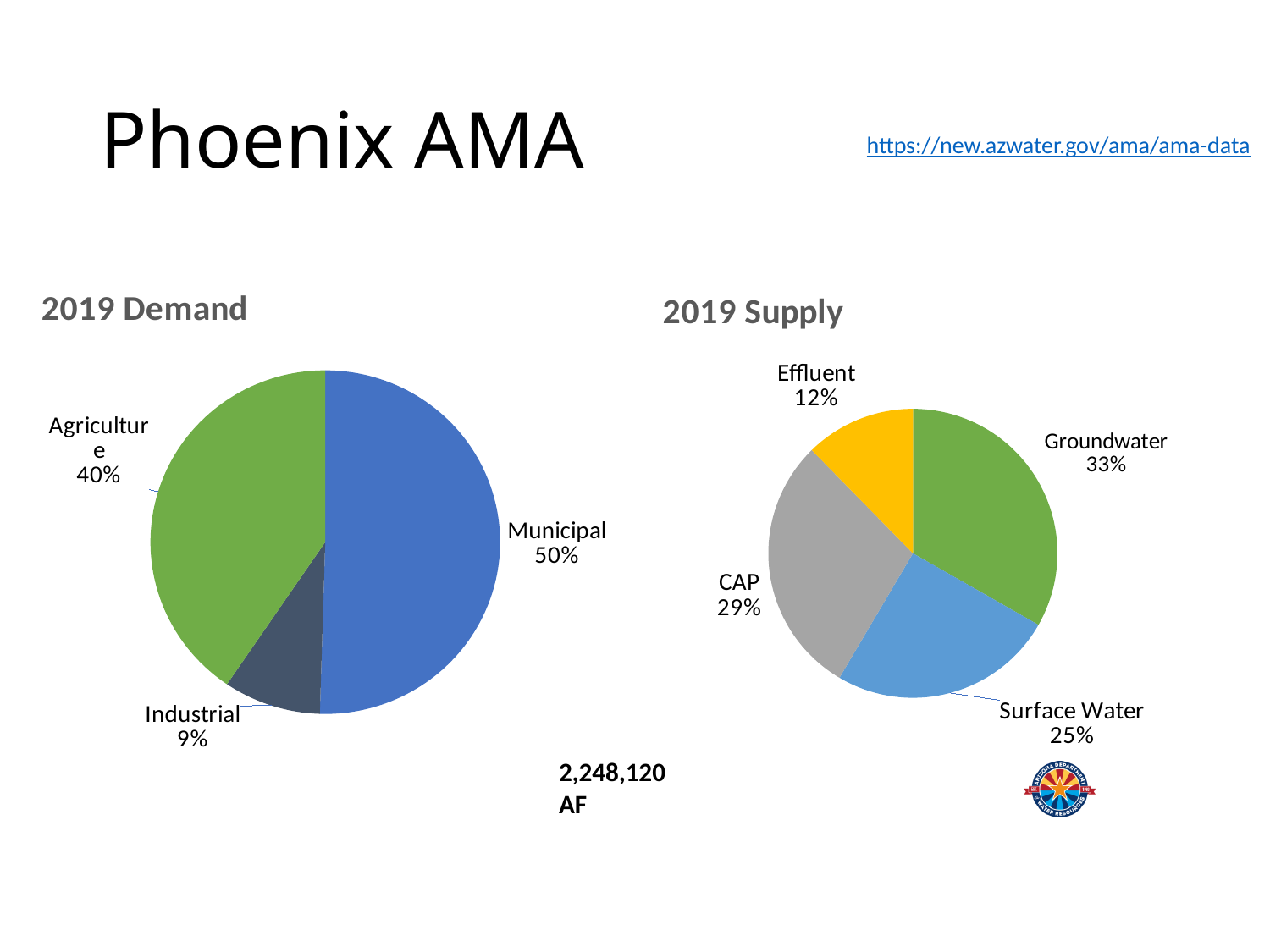
In the 2019 Supply chart, how many categories are shown? 4 What type of chart is the 2019 Demand chart? Pie chart In the 2019 Demand chart, what share does Agriculture have? 40% In the 2019 Supply chart, what is the difference between the CAP share and the Surface Water share? 4% In the 2019 Demand chart, which category has the largest share? Municipal In the 2019 Demand chart, which category has the smallest share? Industrial In the 2019 Supply chart, which is larger, CAP or Effluent? CAP In the 2019 Demand chart, what share does Municipal have? 50% In the 2019 Supply chart, which category has the largest share? Groundwater In the 2019 Demand chart, how many categories are shown? 3 In the 2019 Supply chart, what share does Effluent have? 12%